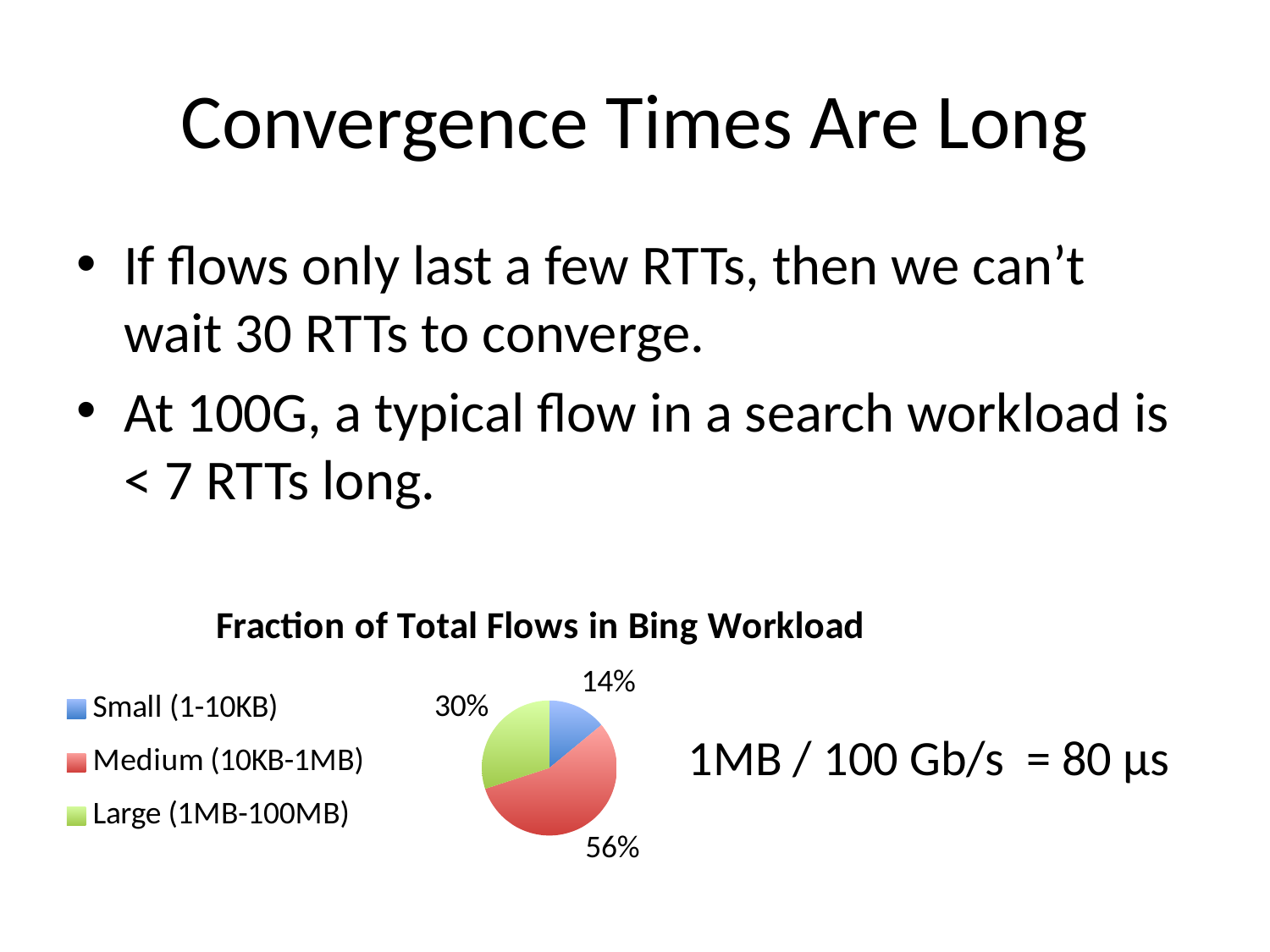
How many percentage points larger is the Medium (10KB-1MB) share than the Large (1MB-100MB) share? 26 Which flow size category has the largest share of total flows in the Bing workload? Medium (10KB-1MB) How many categories does the pie chart show? 3 Which flow size category has the smallest share of total flows in the Bing workload? Small (1-10KB) What share of total flows in the Bing workload are Large (1MB-100MB)? 30% What kind of chart is shown on the slide? Pie chart What share of total flows in the Bing workload are Small (1-10KB)? 14% How many percentage points larger is the Large (1MB-100MB) share than the Small (1-10KB) share? 16 What is the title of the chart? Fraction of Total Flows in Bing Workload Which colour represents Medium (10KB-1MB) flows in the pie chart? Red Which has a larger share of total flows, Small (1-10KB) or Large (1MB-100MB)? Large (1MB-100MB) What share of total flows in the Bing workload are Medium (10KB-1MB)? 56%